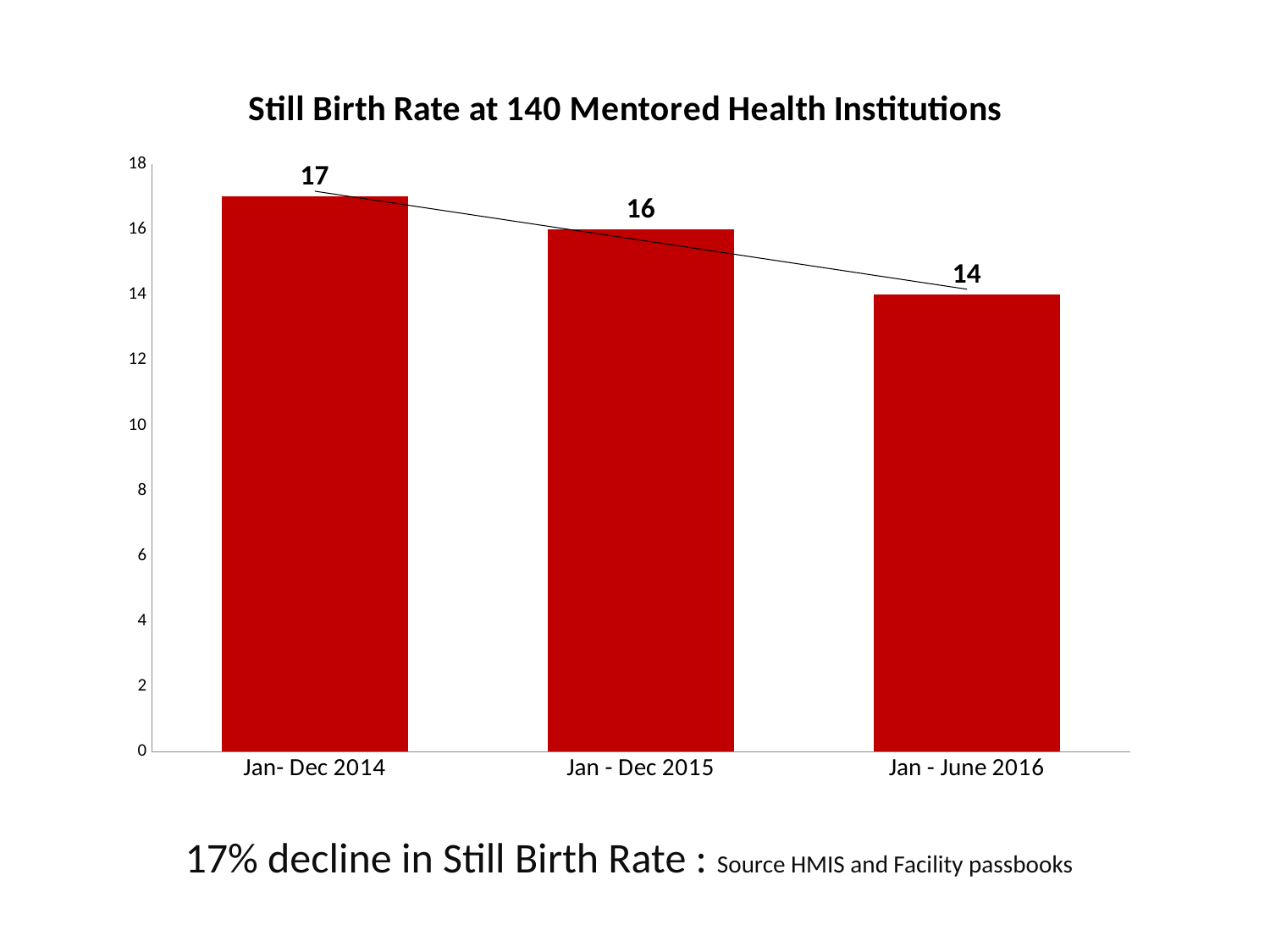
Which period has the lowest still birth rate? Jan - June 2016 What is the still birth rate for Jan - Dec 2015? 16 Which period has the highest still birth rate? Jan- Dec 2014 What is the difference between the still birth rate for Jan - Dec 2015 and Jan - June 2016? 2 What is the still birth rate for Jan- Dec 2014? 17 What is the difference between the still birth rate for Jan- Dec 2014 and Jan - June 2016? 3 What kind of chart is shown on the slide? Bar chart How many periods are shown on the chart? 3 What is the still birth rate for Jan - June 2016? 14 Which is larger, the still birth rate for Jan - Dec 2015 or Jan - June 2016? Jan - Dec 2015 Do the values rise or fall from Jan- Dec 2014 to Jan - June 2016? Fall What is the title of the chart? Still Birth Rate at 140 Mentored Health Institutions